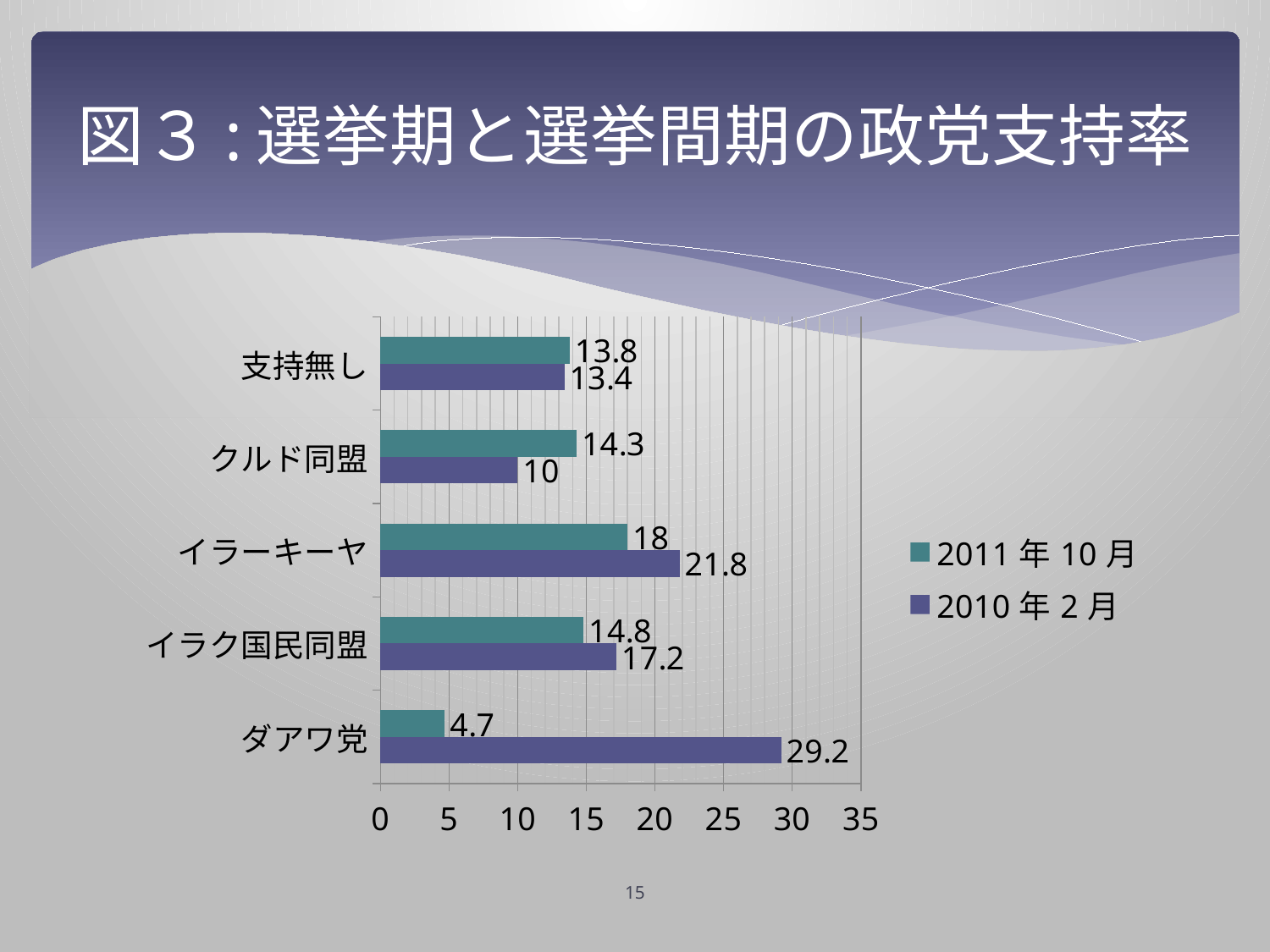
What is the value for クルド同盟 in the 2011年10月 series? 14.3 Which category has the highest value in the 2010年2月 series? ダアワ党 Which category has the lowest value in the 2011年10月 series? ダアワ党 What is the difference between the 2010年2月 and 2011年10月 values for ダアワ党? 24.5 For イラク国民同盟, which series has the larger value, 2011年10月 or 2010年2月? 2010年2月 Is the 2010年2月 value for クルド同盟 greater or less than 15? less What is the value for イラーキーヤ in the 2010年2月 series? 21.8 How many categories are shown on the chart? 5 What is the title of the chart on the slide? 図３：選挙期と選挙間期の政党支持率 What is the value for ダアワ党 in the 2010年2月 series? 29.2 How many series does the legend list? 2 What type of chart is shown on the slide? bar chart